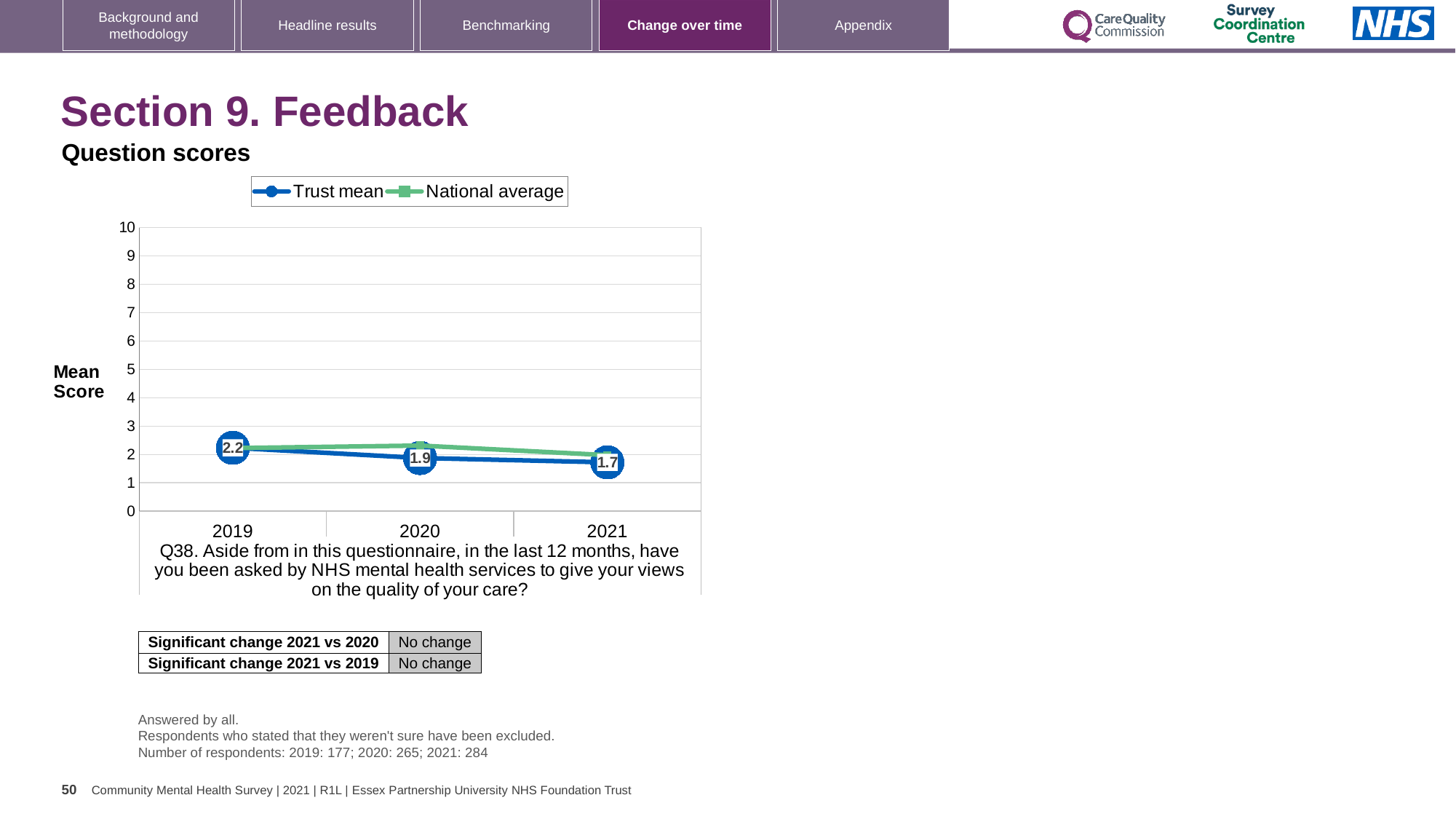
What is the Trust mean score for 2021? 1.7 Which is larger, the Trust mean score in 2019 or in 2021? 2019 Does the Trust mean score rise or fall from 2019 to 2021? fall What kind of chart is shown on the slide? line chart In which year is the Trust mean score lowest? 2021 What is the Trust mean score for 2019? 2.2 How many years are plotted on the x axis? 3 How many series does the legend list? 2 What is the Trust mean score for 2020? 1.9 Is the National average value for 2020 greater or less than 3? less What is the difference between the Trust mean score in 2019 and in 2021? 0.5 In which year is the Trust mean score highest? 2019